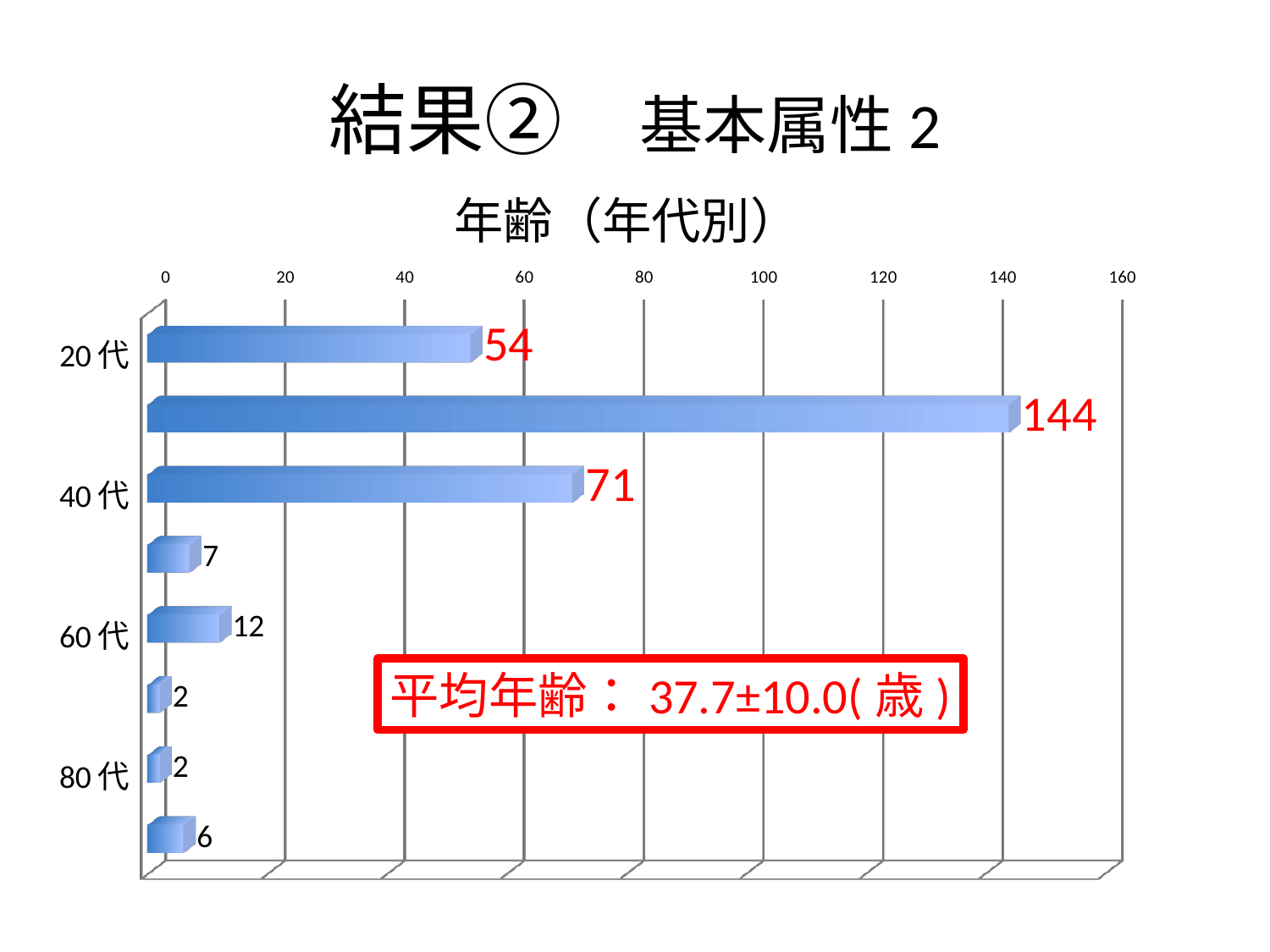
What is the value for 60代? 12 What is the value for 80代? 2 How many bars are plotted in the chart? 8 What is the value for 40代? 71 What is the difference between the values for 60代 and 80代? 10 What is the value shown on the longest bar in the chart? 144 What is the title of the chart? 年齢（年代別） Which has the larger value, 20代 or 40代? 40代 What is the difference between the values for 40代 and 20代? 17 What kind of chart is shown on the slide? bar chart Is the value for 20代 greater or less than 40? greater What is the value for 20代? 54